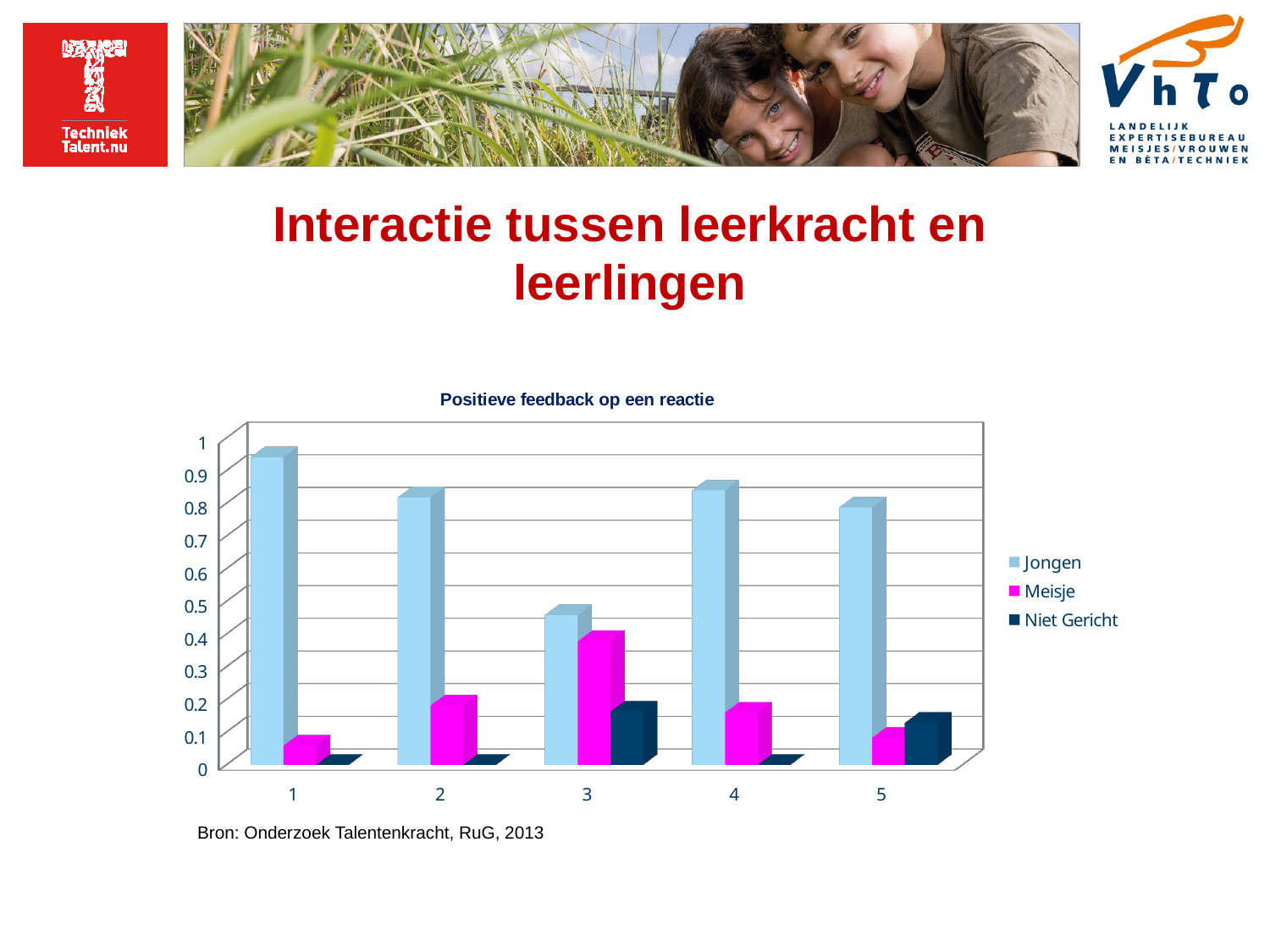
What is the title of the chart? Positieve feedback op een reactie What kind of chart is shown on the slide? bar chart For which category is the Jongen value highest? 1 How many series does the legend list? 3 Is the Meisje value for category 3 greater or less than 0.3? greater How many categories are shown on the x axis? 5 For which category is the Jongen value lowest? 3 In category 3, which is larger: the Jongen value or the Meisje value? Jongen Which series are listed in the legend? Jongen, Meisje, Niet Gericht Is the Jongen value for category 3 greater or less than 0.5? less Is the Jongen value for category 1 greater or less than 0.8? greater For which category is the Meisje value highest? 3